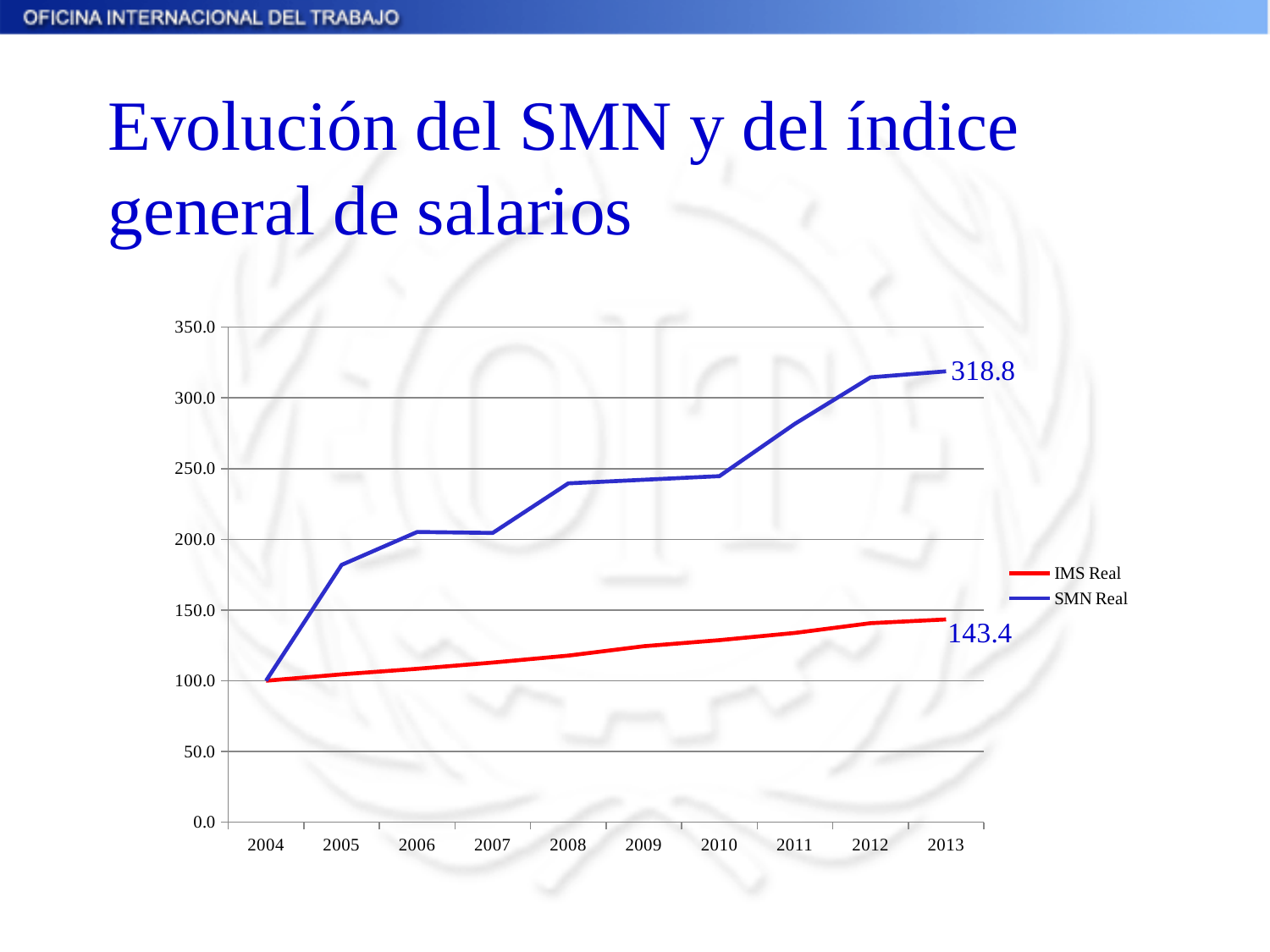
What kind of chart is shown on the slide? line chart Is the value of SMN Real in 2012 greater or less than 300.0? greater What is the value of SMN Real in 2013? 318.8 How many series does the legend list? 2 Which series has the higher value in 2013, SMN Real or IMS Real? SMN Real What is the value of IMS Real in 2013? 143.4 Is the value of IMS Real in 2010 greater or less than 150.0? less What is the difference between SMN Real and IMS Real in 2013? 175.4 Does the SMN Real series rise or fall from 2004 to 2013? rise Is the value of SMN Real in 2005 greater or less than 150.0? greater How many years are shown on the x axis of the chart? 10